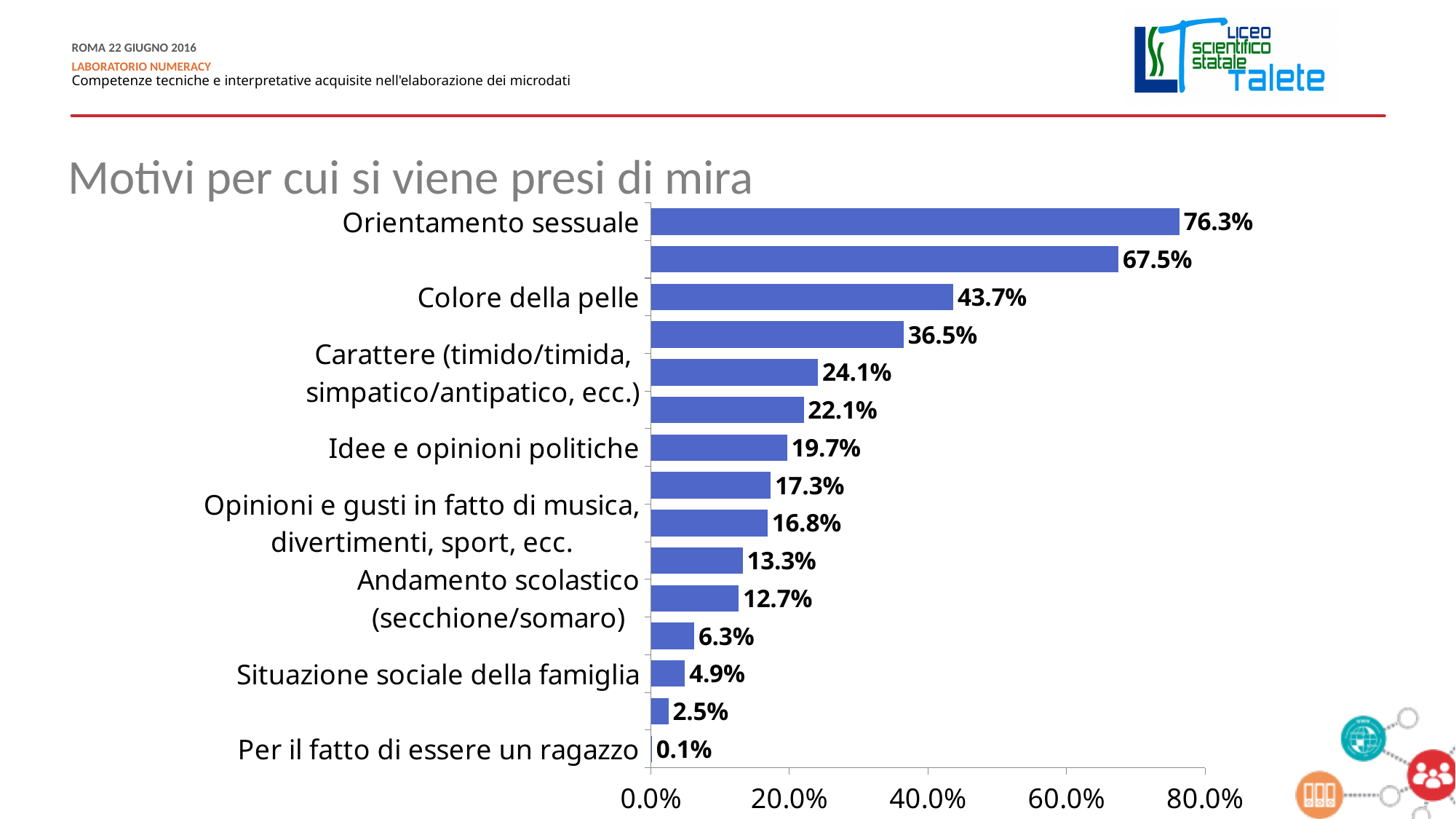
What kind of chart is shown on the slide? Bar chart What is the value for Orientamento sessuale? 76.3% What is the value for Colore della pelle? 43.7% Which category has the lowest value? Per il fatto di essere un ragazzo Is the value for Orientamento sessuale greater or less than 60.0%? greater How many bars are plotted in the chart? 15 Which category has the highest value? Orientamento sessuale What is the value for Per il fatto di essere un ragazzo? 0.1% Which is larger, the value for Colore della pelle or the value for Idee e opinioni politiche? Colore della pelle What is the value for Idee e opinioni politiche? 19.7% What is the value for Situazione sociale della famiglia? 4.9% What is the difference between the values for Orientamento sessuale and Colore della pelle? 32.6%